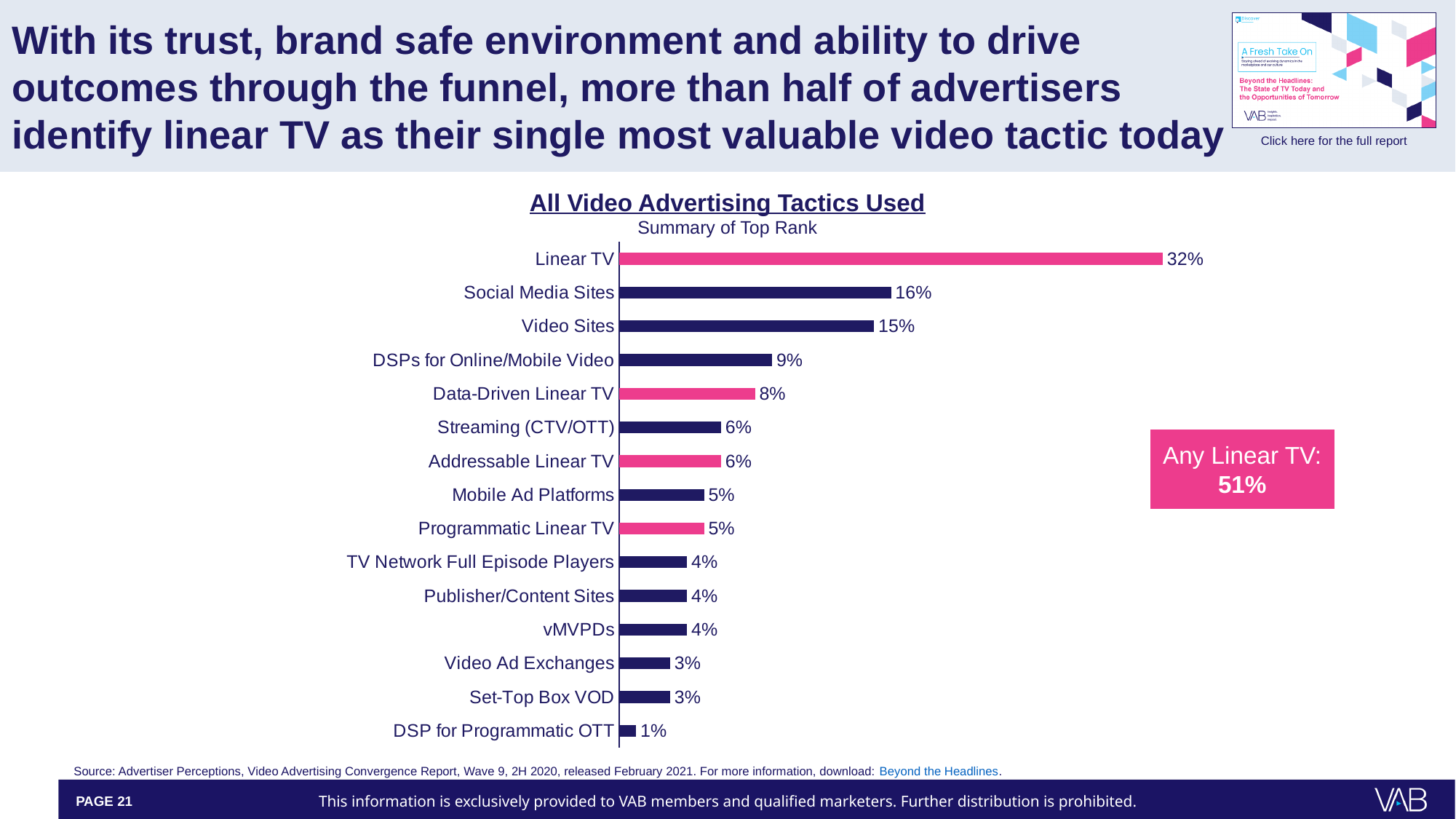
How many categories are shown in the chart? 15 Which category has the lowest value? DSP for Programmatic OTT Which category has the highest value? Linear TV Which is larger, the value for Social Media Sites or the value for Video Sites? Social Media Sites What is the difference between the values for Linear TV and Social Media Sites? 16% What is the difference between the values for Video Sites and Streaming (CTV/OTT)? 9% What is the value for Data-Driven Linear TV? 8% What is the value for Linear TV? 32% What kind of chart is shown on the slide? Bar chart What is the value for DSPs for Online/Mobile Video? 9% What is the value for Social Media Sites? 16% What is the title of the chart? All Video Advertising Tactics Used